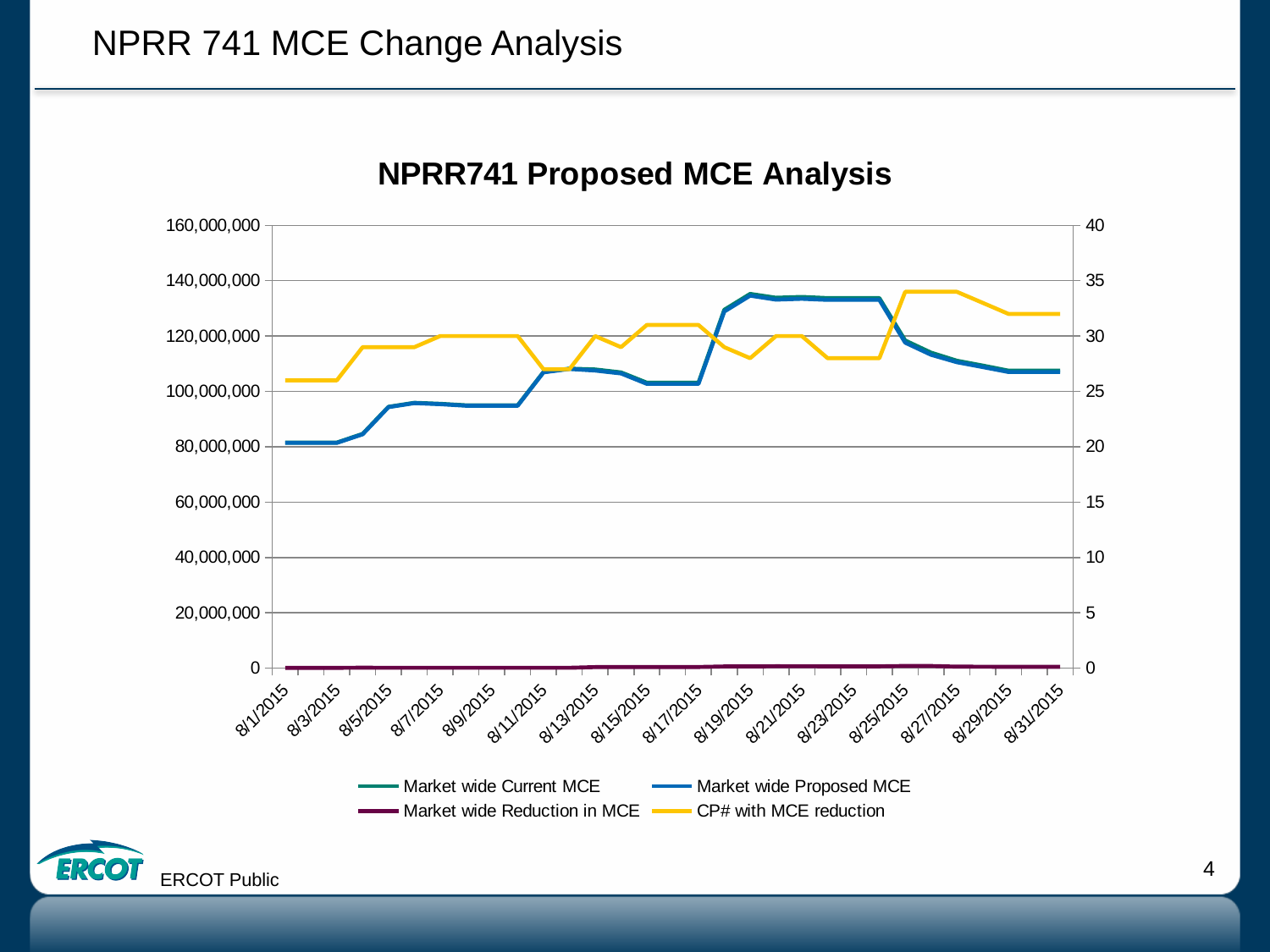
Which series is drawn in yellow? CP# with MCE reduction Is the value for Market wide Proposed MCE on 8/19/2015 greater or less than 120,000,000? greater Is the value for CP# with MCE reduction on 8/1/2015 greater or less than 20? greater Does the Market wide Proposed MCE line rise or fall between 8/25/2015 and 8/31/2015? fall What is the title of the chart? NPRR741 Proposed MCE Analysis Is the value for Market wide Proposed MCE on 8/31/2015 greater or less than 100,000,000? greater How many series does the legend list? 4 What kind of chart is shown on the slide? line chart Does the Market wide Proposed MCE line rise or fall between 8/1/2015 and 8/19/2015? rise Is the Market wide Proposed MCE value larger on 8/19/2015 or on 8/1/2015? 8/19/2015